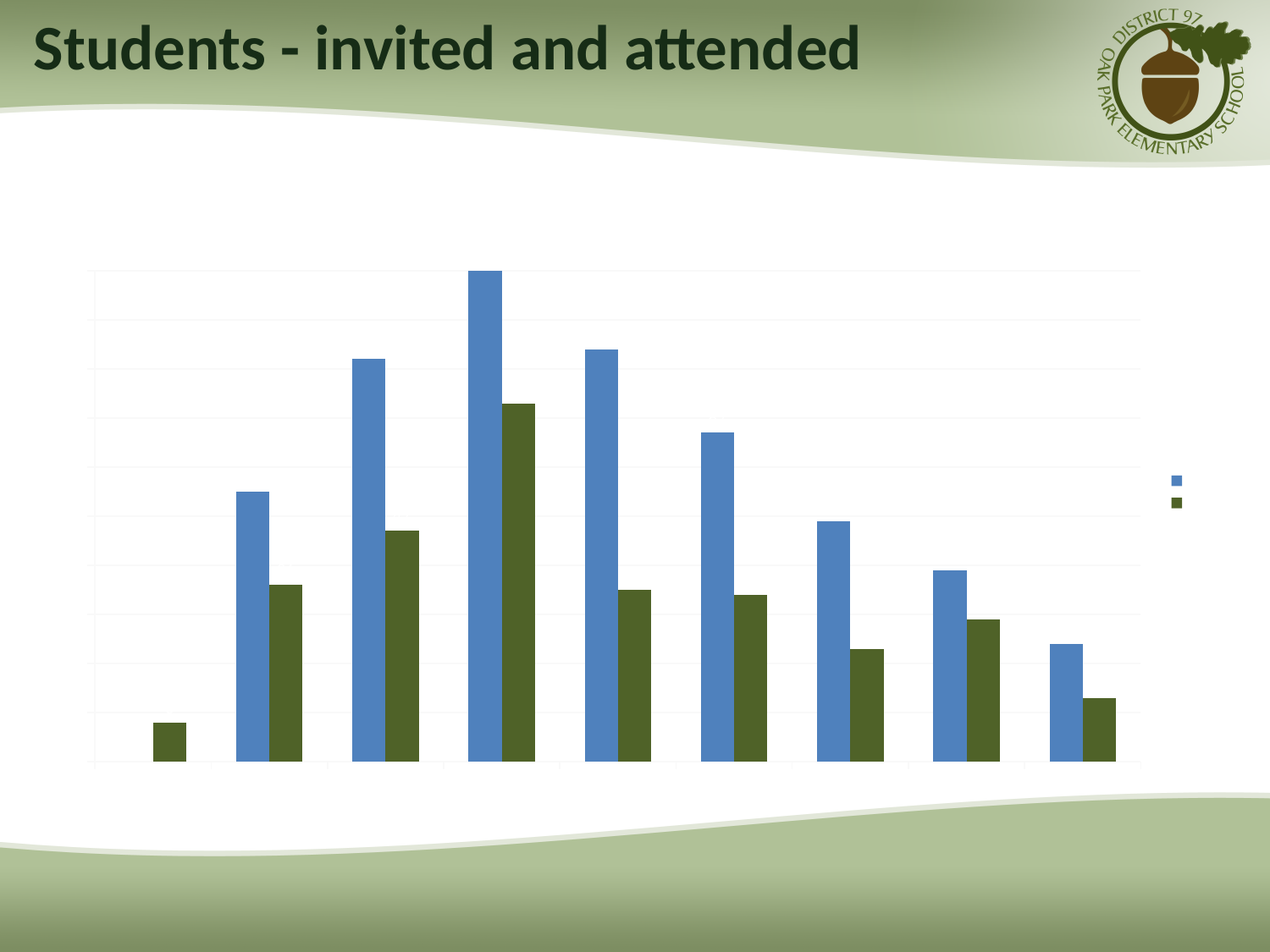
In every group that has both bars, which bar is taller, the blue one or the green one? the blue one What kind of chart is shown on the slide? bar chart How many series does the legend list? 2 Counting from the left, which group of bars has only a green bar and no blue bar? the first What is the title of the slide containing the chart? Students - invited and attended Counting from the left, which group of bars contains the tallest bar in the chart? the fourth What two colours are used for the bars in the chart? blue and green How many groups of bars are plotted along the x axis? 9